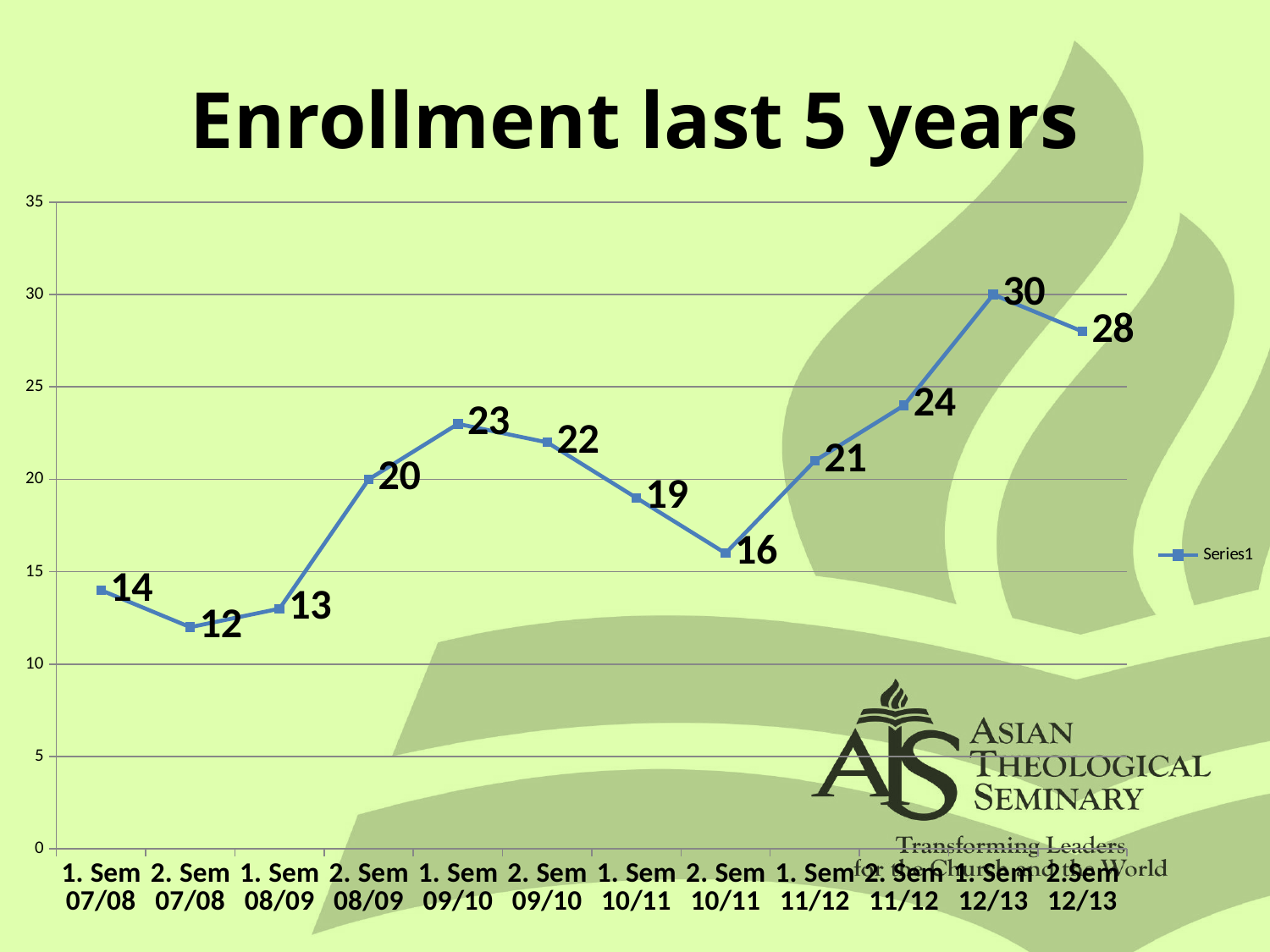
Which semester has the highest enrollment? 1. Sem 12/13 How many semesters are plotted on the chart? 12 What is the title of the chart? Enrollment last 5 years Which semester has the lowest enrollment? 2. Sem 07/08 What is the enrollment value for 2. Sem 12/13? 28 How many series does the legend list? 1 What is the enrollment value for 2. Sem 07/08? 12 What is the difference in enrollment between 1. Sem 12/13 and 2. Sem 10/11? 14 What is the enrollment value for 1. Sem 09/10? 23 Which is larger, the enrollment for 2. Sem 09/10 or for 1. Sem 11/12? 2. Sem 09/10 What kind of chart is shown on the slide? line chart Is the enrollment value for 2. Sem 11/12 greater or less than 20? greater